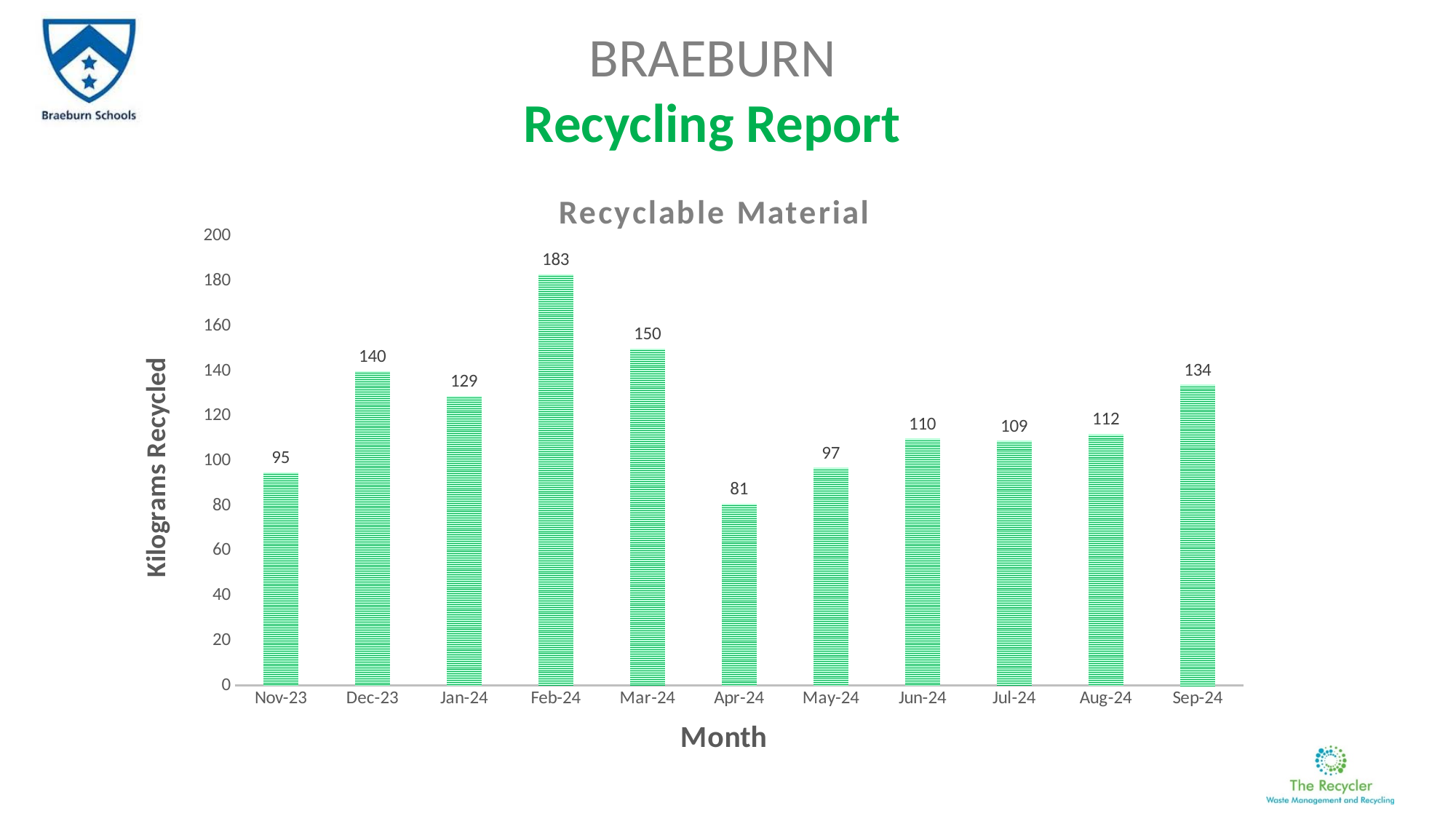
What is the value for Feb-24? 183 Which month has the lowest value? Apr-24 How many months are shown on the x axis? 11 What is the difference between the values for Feb-24 and Mar-24? 33 What is the title of the chart? Recyclable Material What is the label of the vertical axis? Kilograms Recycled Which is larger, the value for Dec-23 or the value for Jan-24? Dec-23 Is the value for Mar-24 greater or less than 140? greater Which month has the highest value? Feb-24 What is the value for Apr-24? 81 What kind of chart is this? bar chart What is the value for Sep-24? 134